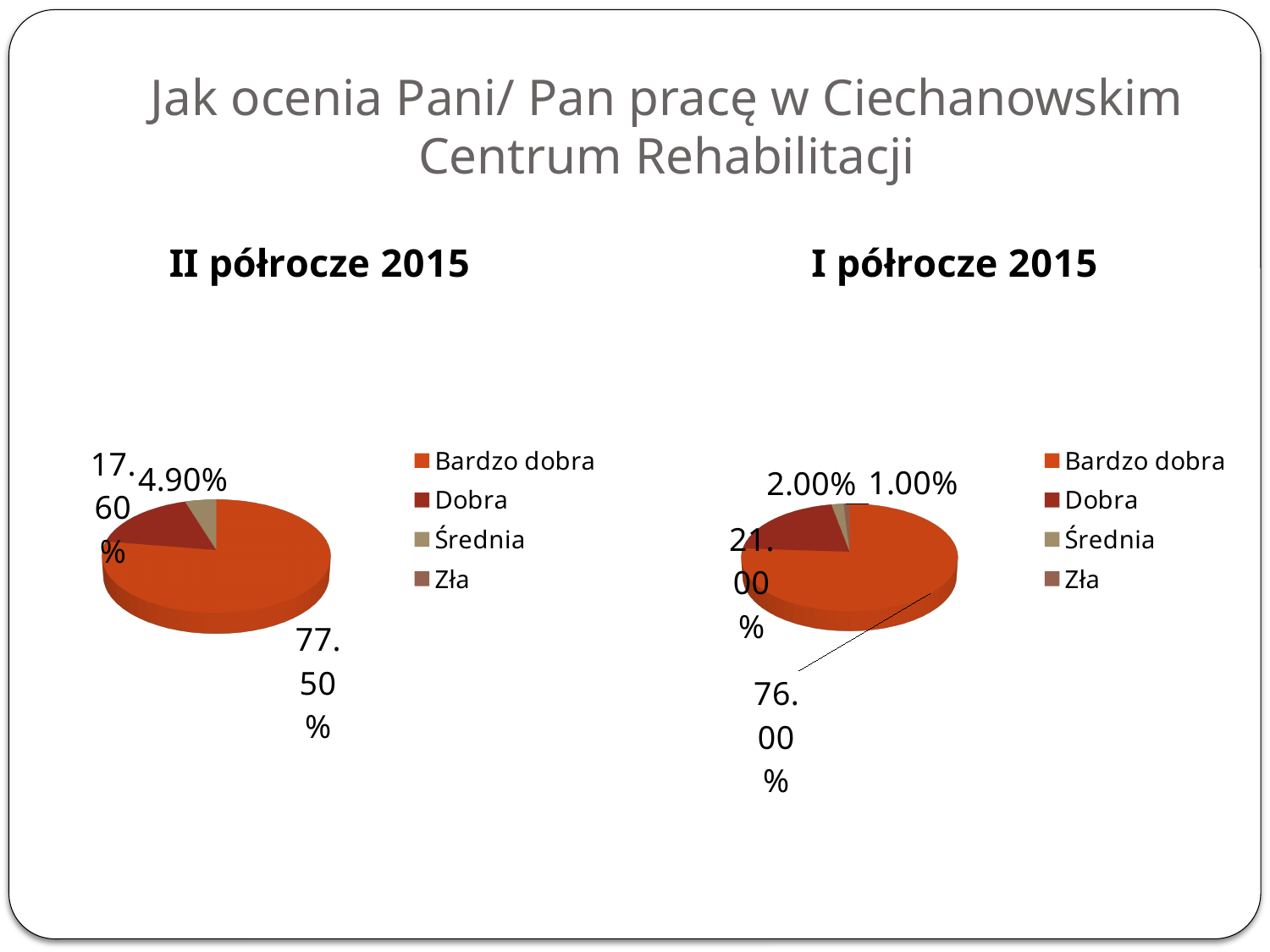
How many entries does the legend of the I półrocze 2015 chart list? 4 In the II półrocze 2015 chart, what percentage is shown for Dobra? 17.60% In the I półrocze 2015 chart, which category has the largest share? Bardzo dobra What type of chart is used for II półrocze 2015? Pie chart In the II półrocze 2015 chart, what percentage is shown for Średnia? 4.90% In the I półrocze 2015 chart, which category has the smallest share? Zła In the I półrocze 2015 chart, what percentage is shown for Bardzo dobra? 76.00% Which is larger: the Dobra share in the II półrocze 2015 chart or the Dobra share in the I półrocze 2015 chart? I półrocze 2015 In the I półrocze 2015 chart, what percentage is shown for Zła? 1.00% In the II półrocze 2015 chart, what percentage is shown for Bardzo dobra? 77.50% In the I półrocze 2015 chart, what is the difference between the Dobra and Średnia shares? 19.00% In the I półrocze 2015 chart, what percentage is shown for Dobra? 21.00%